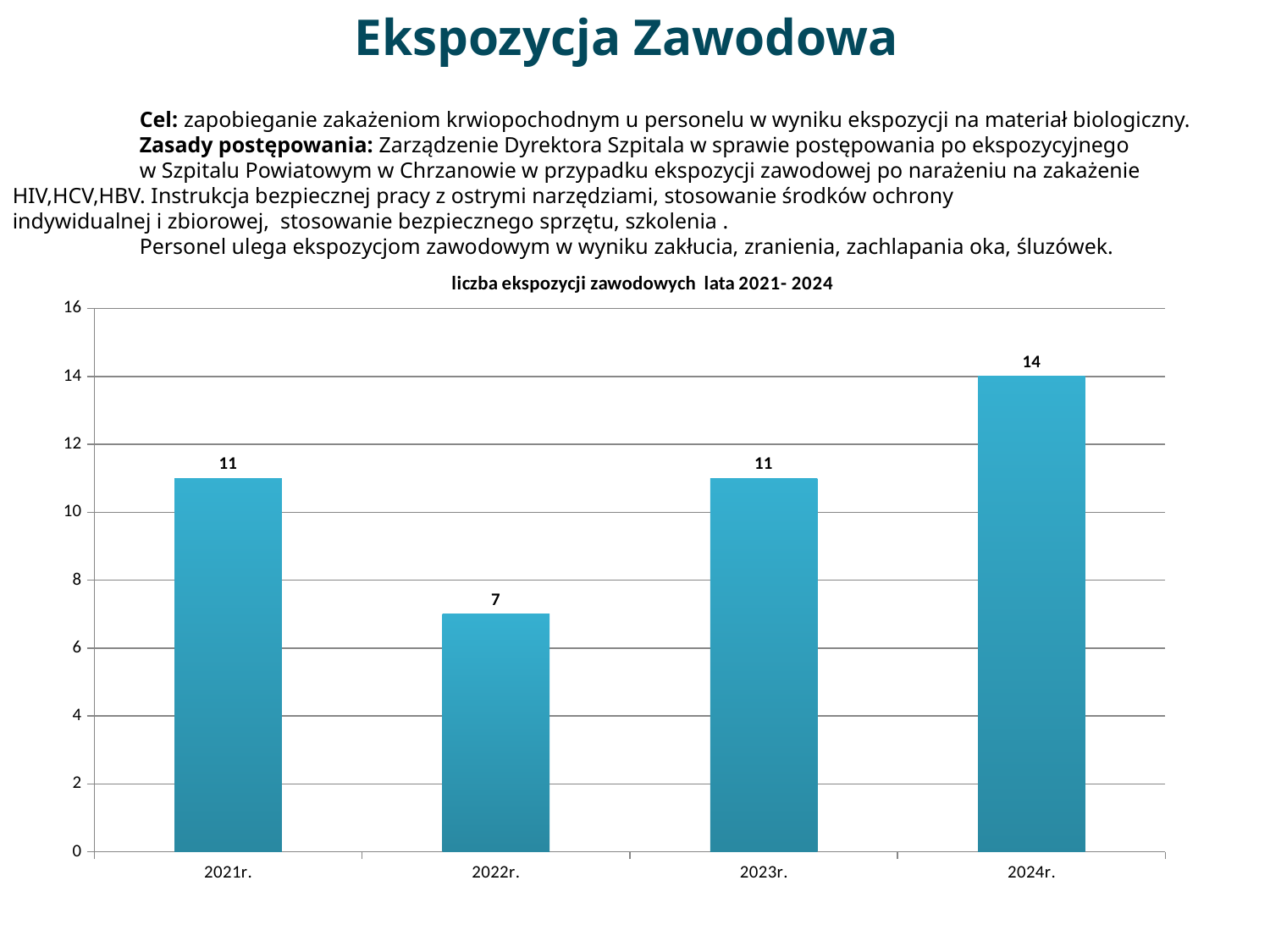
What is the difference between the values for 2024r. and 2023r.? 3 What is the number of occupational exposures shown for 2022r.? 7 What is the title of the chart? liczba ekspozycji zawodowych lata 2021- 2024 What is the difference between the values for 2024r. and 2022r.? 7 How many years are shown on the x axis of the chart? 4 Which year has the highest number of occupational exposures? 2024r. Which year has the lowest number of occupational exposures? 2022r. Is the value for 2024r. greater or less than 12? greater What kind of chart is shown on the slide? Bar chart Which is larger, the value for 2023r. or the value for 2022r.? 2023r. What is the value shown for 2024r.? 14 What is the value shown for 2021r.? 11